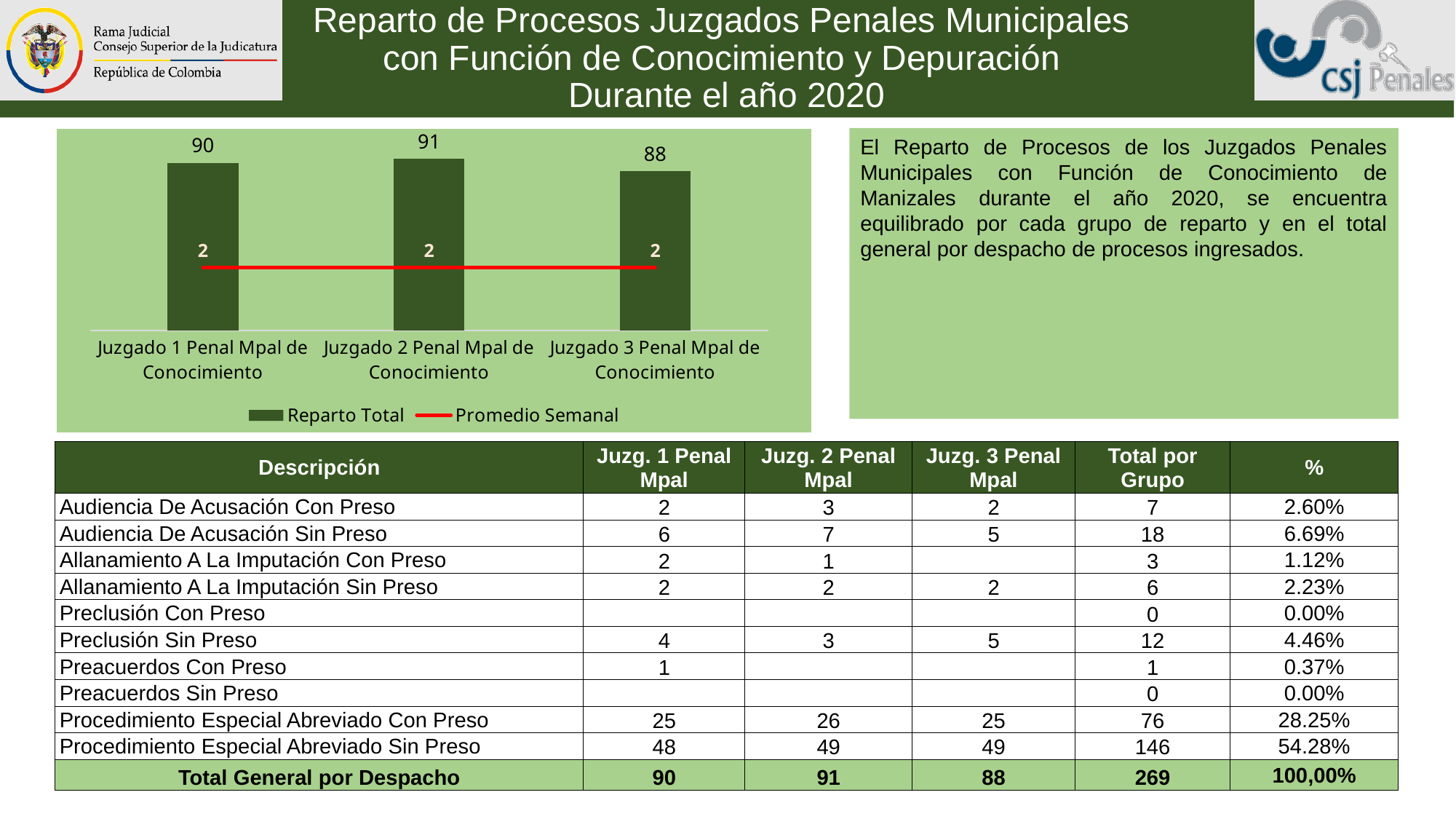
Which juzgado has the highest Reparto Total? Juzgado 2 Penal Mpal de Conocimiento How many series does the chart legend list? 2 What colour is the Promedio Semanal line in the chart? Red What is the Reparto Total value for Juzgado 3 Penal Mpal de Conocimiento? 88 Which has a larger Reparto Total, Juzgado 1 or Juzgado 3 Penal Mpal de Conocimiento? Juzgado 1 Penal Mpal de Conocimiento How many juzgados (categories) are shown on the x axis of the chart? 3 What is the Promedio Semanal value for Juzgado 1 Penal Mpal de Conocimiento? 2 Which juzgado has the lowest Reparto Total? Juzgado 3 Penal Mpal de Conocimiento What is the difference in Reparto Total between Juzgado 2 and Juzgado 3 Penal Mpal de Conocimiento? 3 Does the Promedio Semanal line rise, fall, or stay flat across the three juzgados? Stays flat What kind of chart is used to show the Reparto Total values? Bar chart What is the Reparto Total value for Juzgado 2 Penal Mpal de Conocimiento? 91